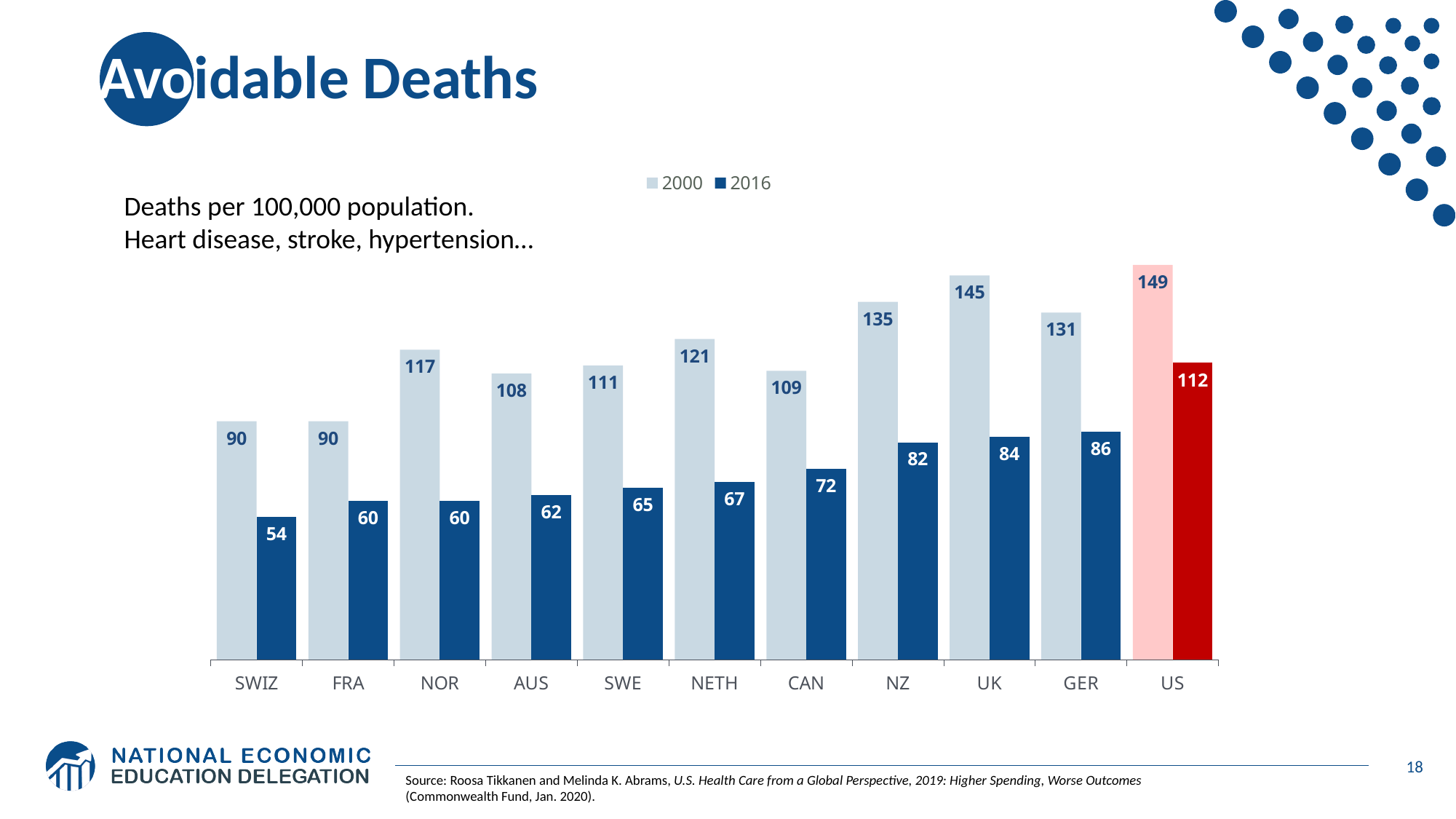
Which country's bars are highlighted in red/pink rather than blue? US Which country had the highest value in 2000? US What is the difference between the 2016 values for the US and GER? 26 By how much did the value for the UK fall from 2000 to 2016? 61 What was the value for NOR in 2000? 117 How many countries are shown on the x axis? 11 How many series does the legend list? 2 What kind of chart is shown on the slide? Bar chart What was the value for SWIZ in 2016? 54 What was the value for the US in 2016? 112 Which country had the lowest value in 2016? SWIZ Which is larger: the 2000 value for NZ or the 2000 value for GER? NZ